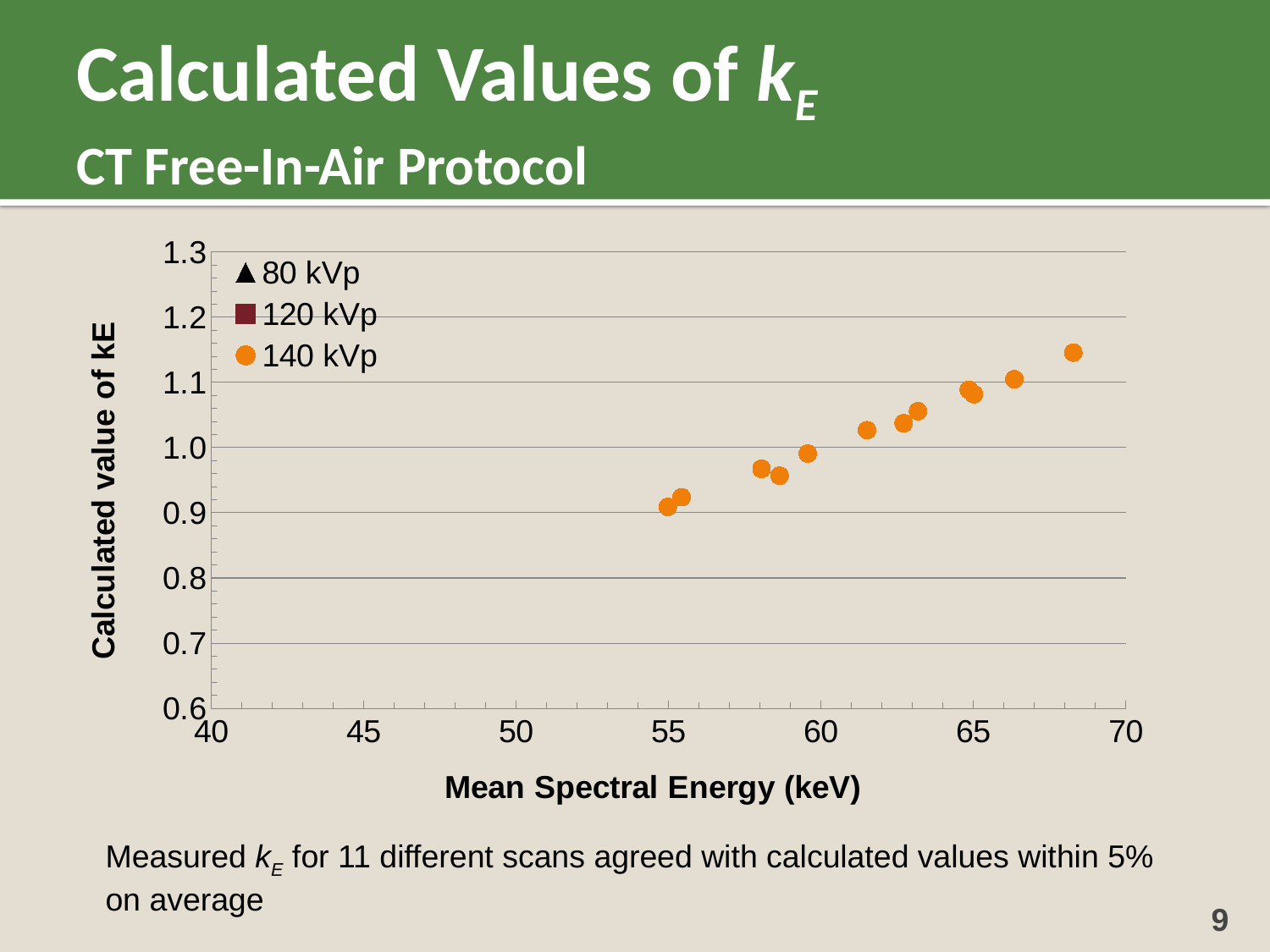
What kind of chart is shown on the slide? scatter chart How many series does the chart's legend list? 3 Is the calculated value of kE for the 140 kVp point at about 68 keV greater or less than 1.1? greater Which series are listed in the chart's legend? 80 kVp, 120 kVp, 140 kVp Which series' points are visibly plotted on the chart? 140 kVp Is the calculated value of kE for the 140 kVp point at about 65 keV greater or less than 1.0? greater Is the calculated value of kE for the 140 kVp point at about 55 keV greater or less than 1.0? less What is the highest value shown on the y axis? 1.3 Do the plotted 140 kVp values rise or fall as mean spectral energy increases along the x axis? rise Which has the larger calculated value of kE: the 140 kVp point at about 68 keV or the one at about 55 keV? the point at about 68 keV